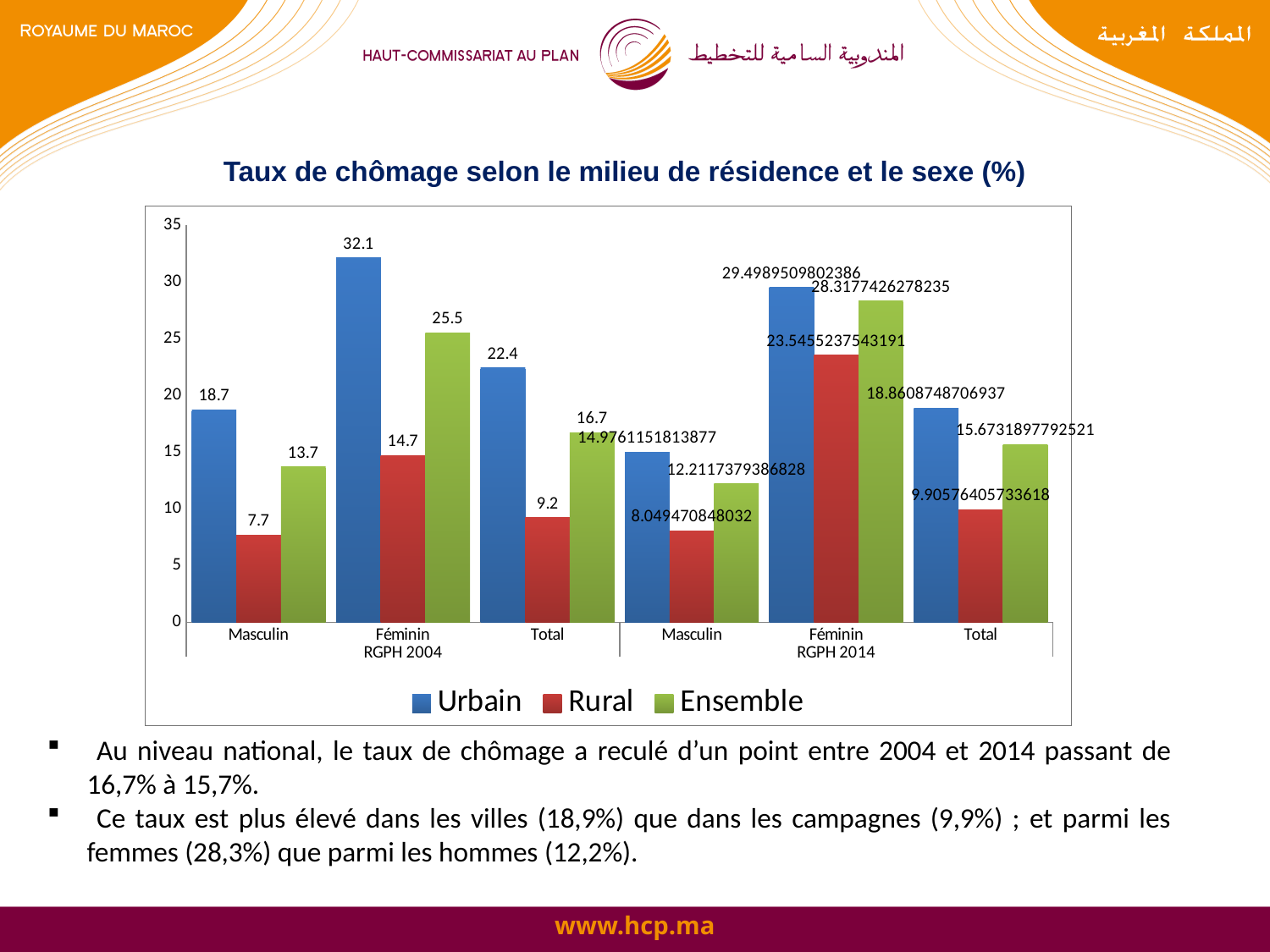
What is the difference between the Urbain and Rural values for Masculin in RGPH 2004? 11 Does the Urbain value for Total rise or fall from RGPH 2004 to RGPH 2014? Fall What kind of chart is shown on the slide? Bar chart Which is larger: the Ensemble value for Féminin in RGPH 2004 or the Ensemble value for Total in RGPH 2004? Féminin Which category and series has the highest bar in the chart? Urbain, Féminin (RGPH 2004) Which series has the lowest value for Masculin in RGPH 2004? Rural What is the Ensemble value for Total in RGPH 2004? 16.7 How many series does the legend list? 3 What is the Urbain value for Masculin in RGPH 2004? 18.7 Is the Rural value for Total in RGPH 2014 greater or less than 10? less What is the Rural value for Féminin in RGPH 2004? 14.7 How many categories are shown on the x axis? 6